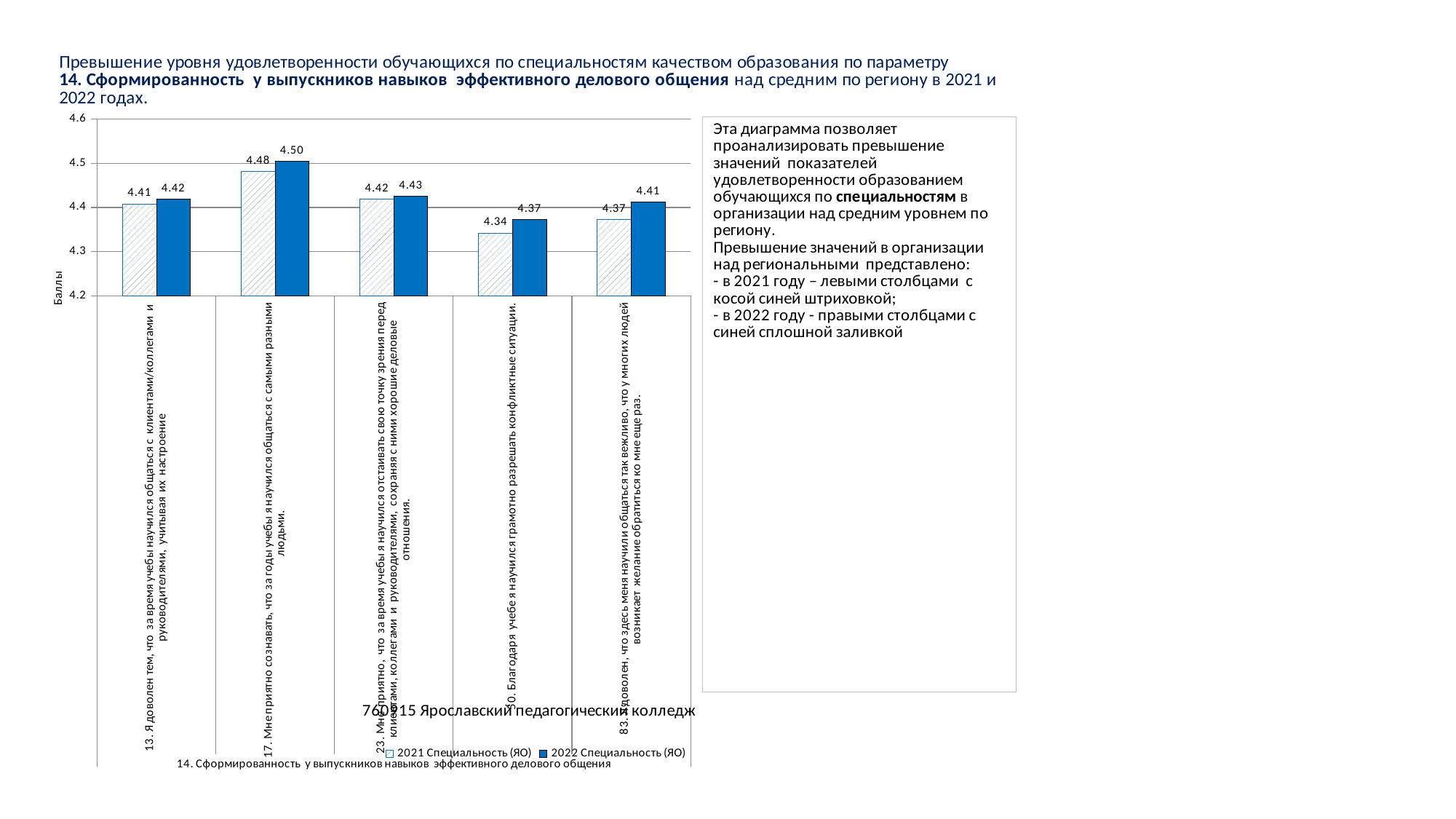
What type of chart is shown on the slide? bar chart How many series does the chart legend list? 2 What is the difference between the 2022 and 2021 Специальность (ЯО) values for statement 83? 0.04 How many categories (statements) are plotted on the x axis of the chart? 5 Is the 2021 Специальность (ЯО) value for statement 17 greater or less than 4.4? greater What is the label of the y axis of the chart? Баллы Which statement has the highest 2022 Специальность (ЯО) value? 17. Мне приятно сознавать, что за годы учебы я научился общаться с самыми разными людьми What is the 2022 Специальность (ЯО) value for statement 17 (Мне приятно сознавать, что за годы учебы я научился общаться с самыми разными людьми)? 4.50 What is the 2021 Специальность (ЯО) value for statement 83 (Я доволен, что здесь меня научили общаться так вежливо...)? 4.37 Which is larger for statement 13: the 2021 Специальность (ЯО) value or the 2022 Специальность (ЯО) value? 2022 Специальность (ЯО) Which statement has the lowest 2021 Специальность (ЯО) value? 50. Благодаря учебе я научился грамотно разрешать конфликтные ситуации